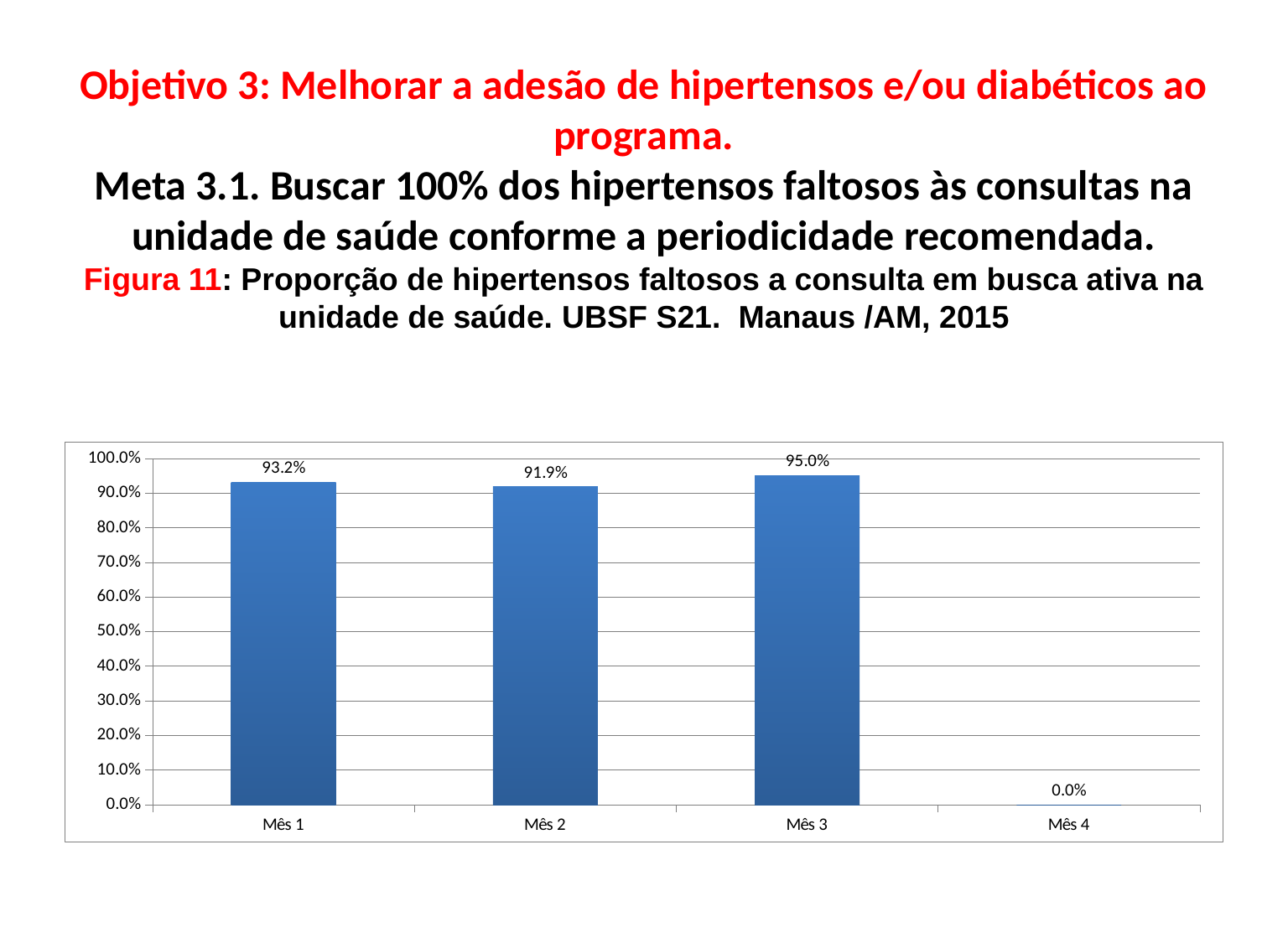
How many months are shown on the x axis? 4 Which month has the lowest value? Mês 4 What is the difference between the values for Mês 3 and Mês 2? 3.1% What is the value for Mês 1? 93.2% Which month has the highest value? Mês 3 What kind of chart is shown on the slide? Bar chart What is the figure number given in the chart caption? Figura 11 Is the value for Mês 2 greater or less than 90.0%? greater What is the value for Mês 3? 95.0% What is the value for Mês 4? 0.0% Which is larger, the value for Mês 1 or the value for Mês 2? Mês 1 What is the value for Mês 2? 91.9%